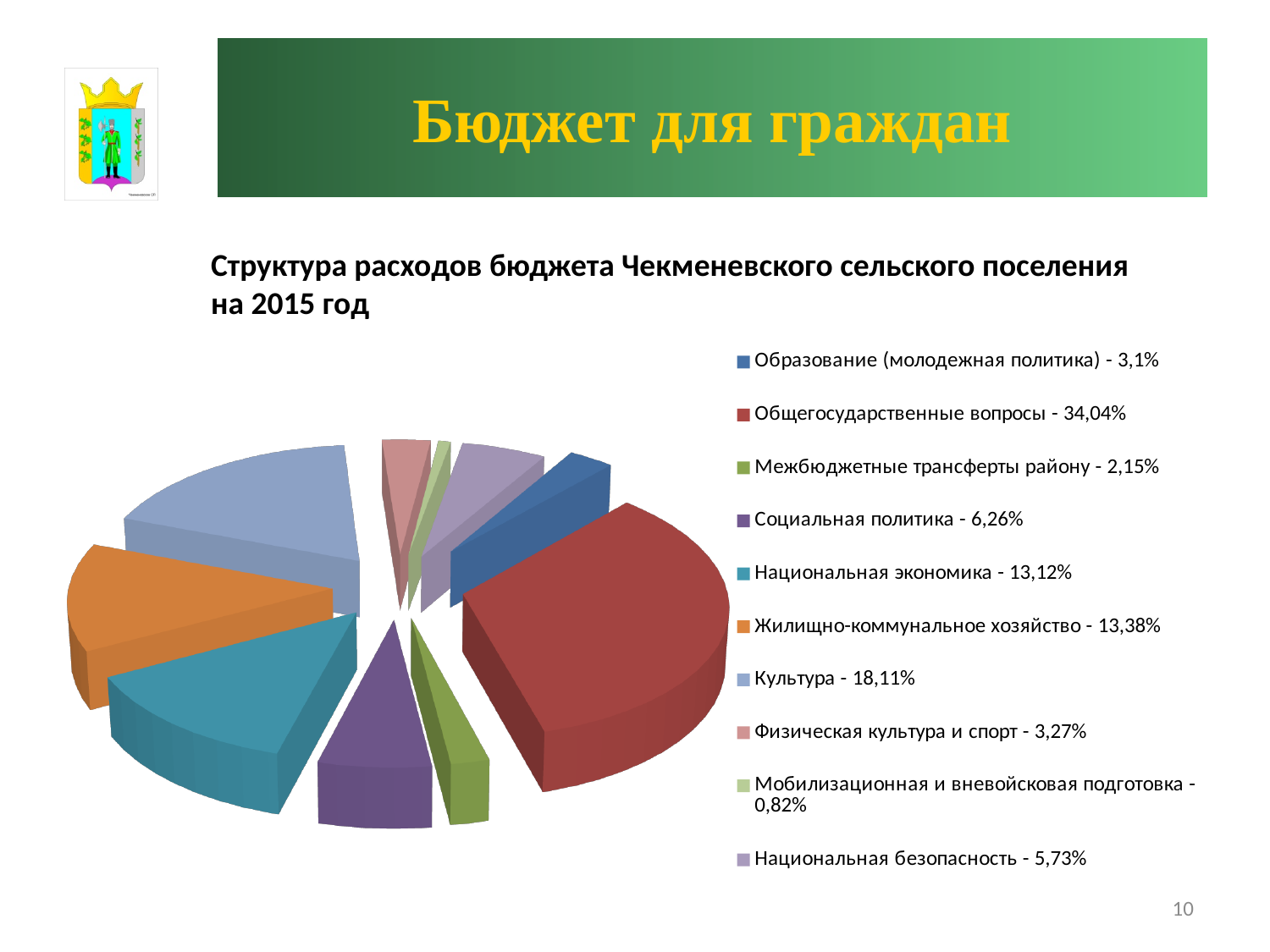
Which category has the smallest share of the budget expenditure? Мобилизационная и вневойсковая подготовка Which category has the largest share of the budget expenditure? Общегосударственные вопросы What percentage is shown for Культура? 18,11% What is the difference in percentage points between Культура and Национальная экономика? 4,99 What is the difference in percentage points between Общегосударственные вопросы and Культура? 15,93 What is the share for Социальная политика? 6,26% How many categories does the chart show? 10 What kind of chart is shown on the slide? Pie chart What share of the budget expenditure goes to Общегосударственные вопросы? 34,04% What is the title of the chart? Структура расходов бюджета Чекменевского сельского поселения на 2015 год Which is larger: the share for Физическая культура и спорт or for Образование (молодежная политика)? Физическая культура и спорт Which is larger: the share for Жилищно-коммунальное хозяйство or for Национальная экономика? Жилищно-коммунальное хозяйство